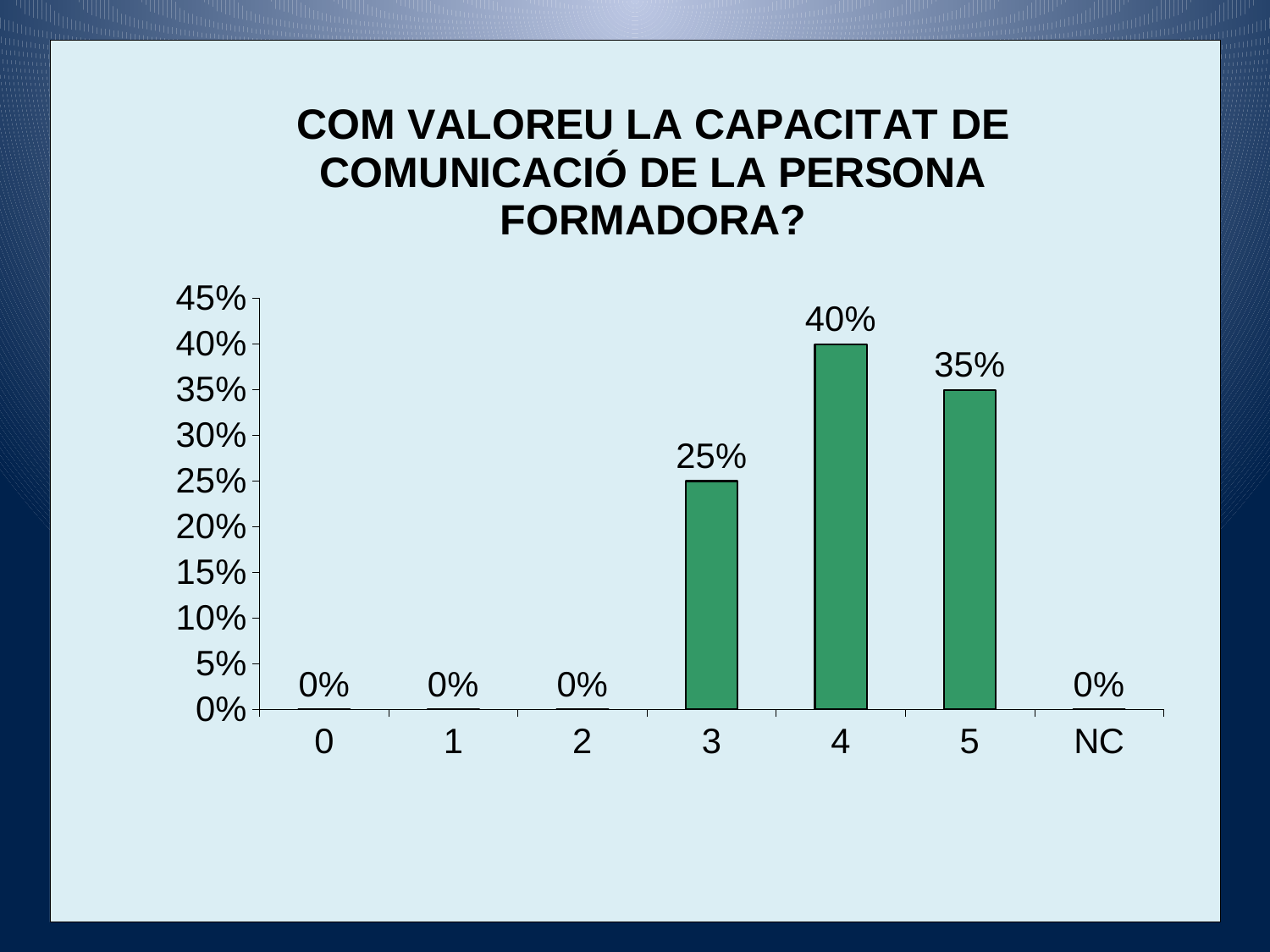
What is the value for category 3? 25% What is the title of the chart? COM VALOREU LA CAPACITAT DE COMUNICACIÓ DE LA PERSONA FORMADORA? What is the difference between the values for categories 4 and 3? 15% What is the difference between the values for categories 4 and 5? 5% What kind of chart is shown on the slide? bar chart Which is larger, the value for category 3 or the value for category 5? 5 How many categories are shown on the x axis? 7 Which category has the highest value? 4 What is the value for category 5? 35% What is the value for category 4? 40% What is the value for the NC category? 0% How many categories have a value of 0%? 4